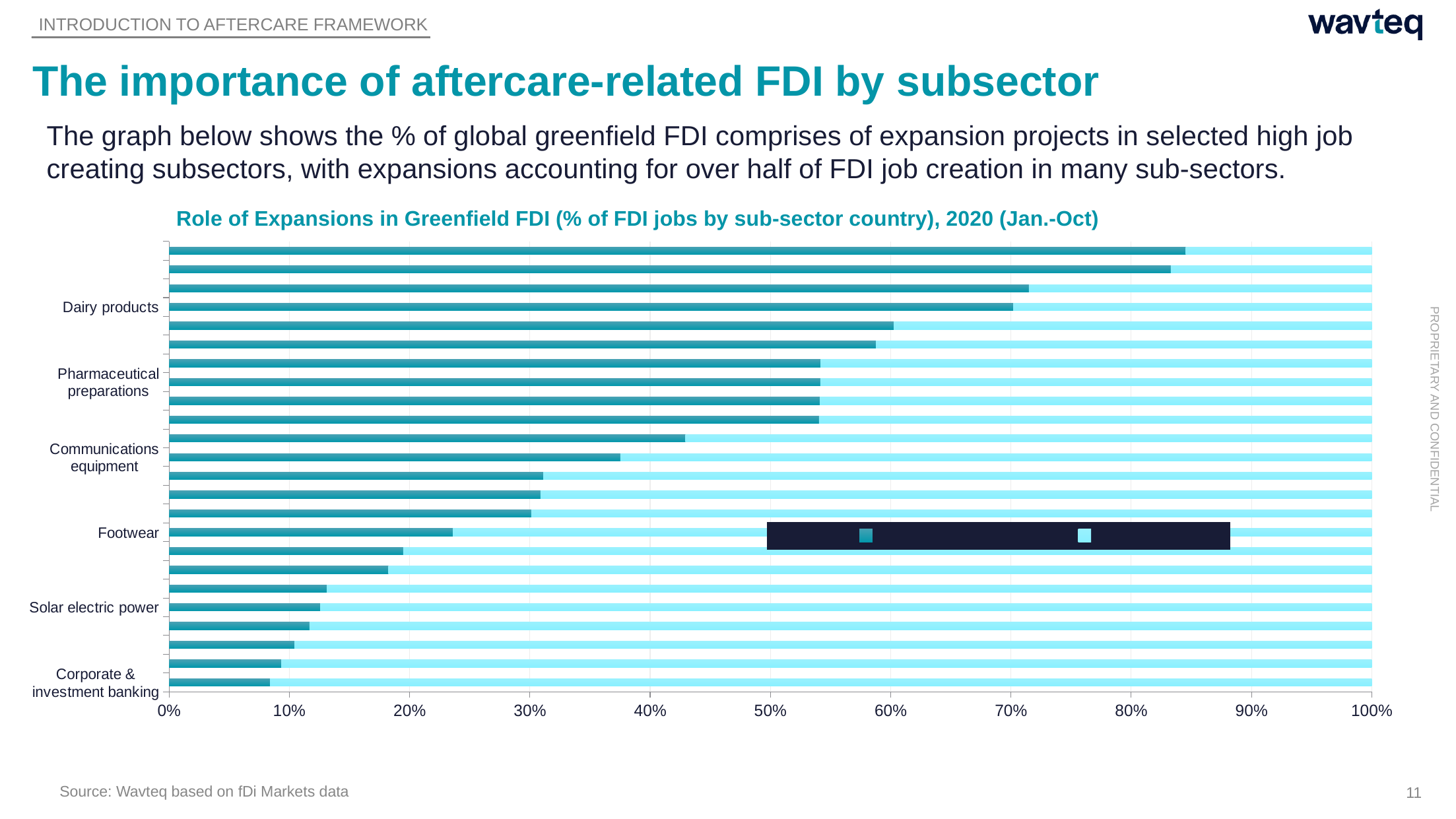
Of the labelled sub-sectors, which has the lowest expansion share? Corporate & investment banking Is the value for Pharmaceutical preparations greater or less than 50%? greater Do the bar values rise or fall moving from the top of the chart to the bottom? fall Which has the larger expansion share: Dairy products or Footwear? Dairy products Is the value for Corporate & investment banking greater or less than 10%? less How many entries does the chart's legend show? 2 Is the value for Dairy products greater or less than 60%? greater What kind of chart is shown on the slide? bar chart What is the title of the chart? Role of Expansions in Greenfield FDI (% of FDI jobs by sub-sector country), 2020 (Jan.-Oct) How many bars (sub-sector rows) are plotted in the chart? 24